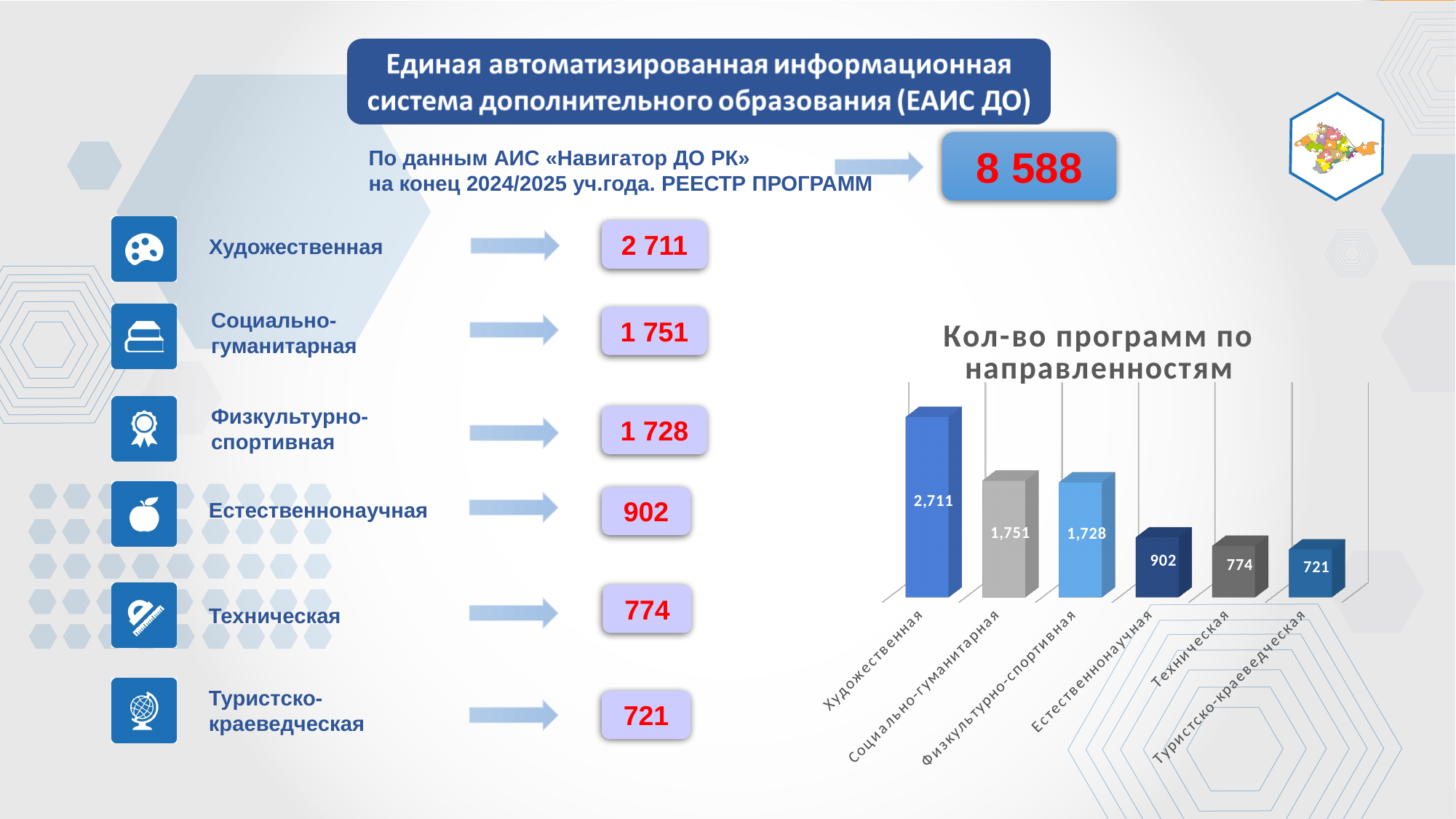
Do the values rise or fall from left to right along the x axis of the chart? fall How many categories are plotted in the chart? 6 Which category has the highest value in the chart? Художественная Which category has the lowest value in the chart? Туристско-краеведческая What is the value for Естественнонаучная in the chart? 902 What is the difference between the values for Художественная and Физкультурно-спортивная? 983 What is the value for Туристско-краеведческая in the chart? 721 What type of chart is shown on the slide? bar chart What is the title of the chart on the slide? Кол-во программ по направленностям What is the value for Социально-гуманитарная in the chart? 1,751 Which is larger, the value for Техническая or the value for Естественнонаучная? Естественнонаучная What is the value for Художественная in the chart? 2,711